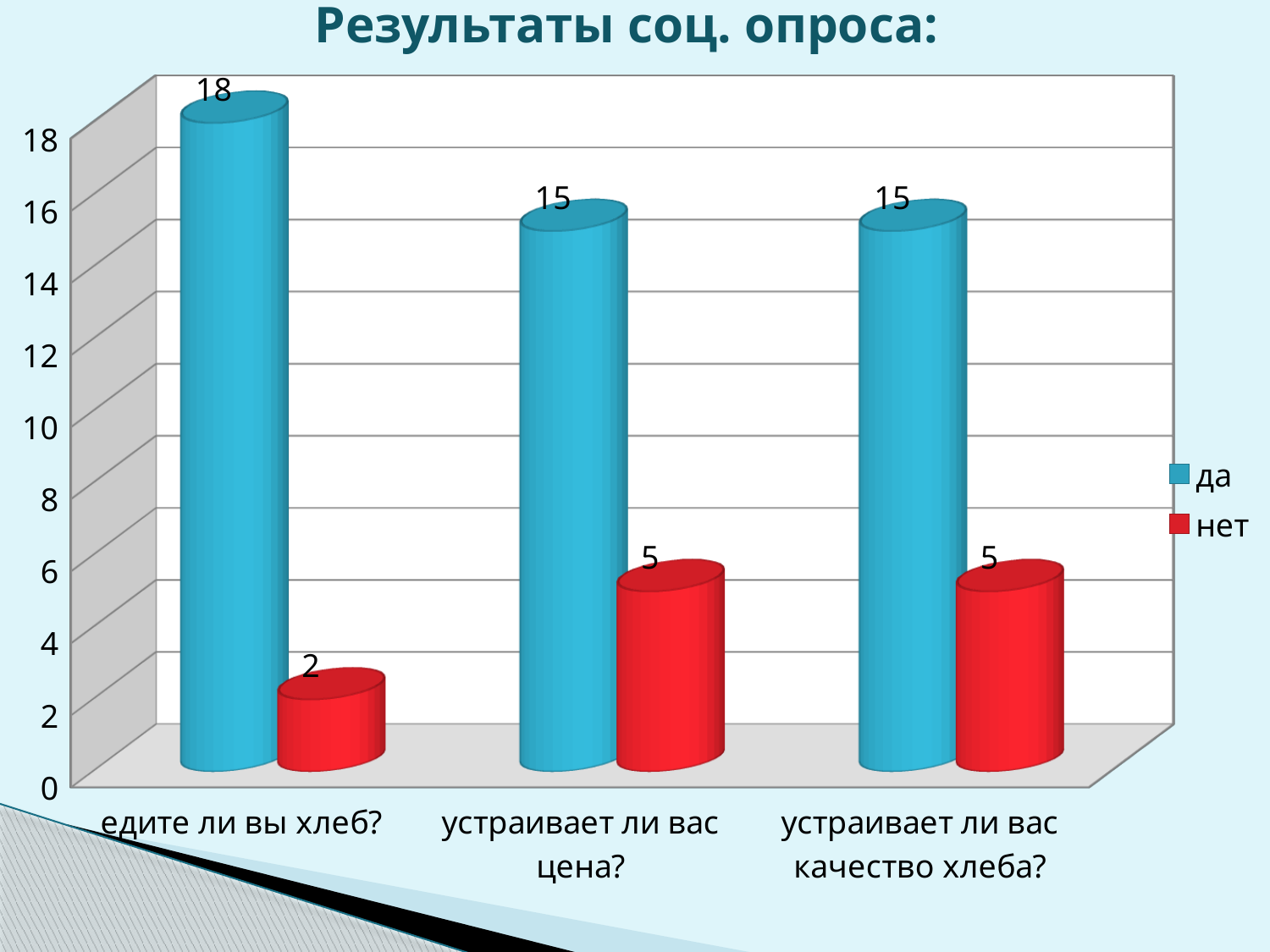
Which category has the highest value for "да"? едите ли вы хлеб? How many categories are shown on the x axis? 3 What is the value for "нет" for the category "устраивает ли вас качество хлеба?"? 5 Which category has the lowest value for "нет"? едите ли вы хлеб? What is the value for "нет" for the category "едите ли вы хлеб?"? 2 What is the difference between the "да" and "нет" values for "устраивает ли вас цена?"? 10 What is the difference between the "да" and "нет" values for "едите ли вы хлеб?"? 16 What is the value for "да" for the category "устраивает ли вас цена?"? 15 How many series does the legend list? 2 Which is larger: the "нет" value for "едите ли вы хлеб?" or the "нет" value for "устраивает ли вас цена?"? устраивает ли вас цена? What is the value for "да" for the category "едите ли вы хлеб?"? 18 What kind of chart is shown on the slide? Bar chart